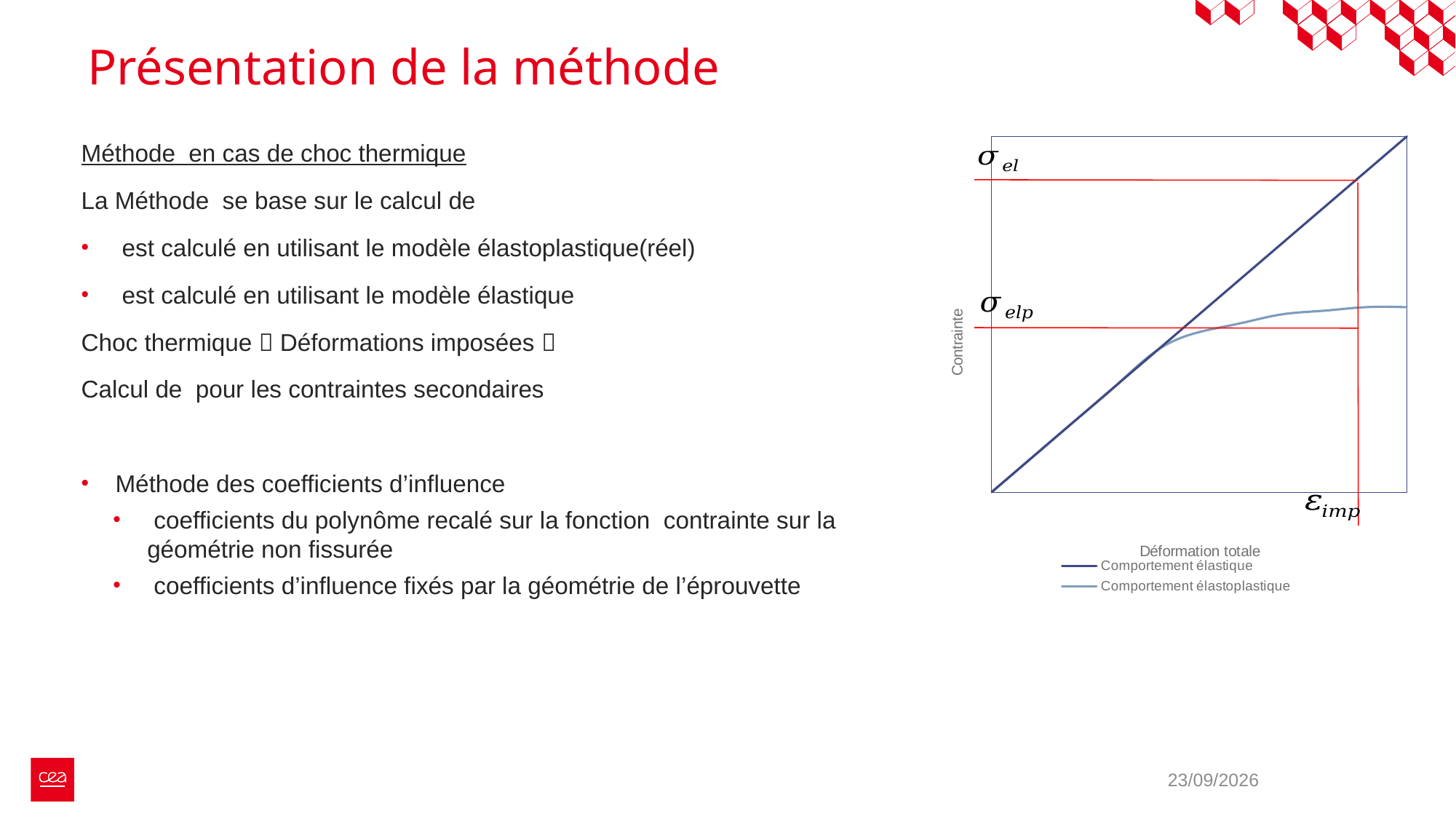
Which series has the lower value at the right end of the chart? Comportement élastoplastique Which stress level marked on the chart is higher: σ_el or σ_elp? σ_el What is the label of the vertical axis of the chart? Contrainte Which series has the higher value at the right end of the chart? Comportement élastique At the strain ε_imp, which series reaches the higher stress: 'Comportement élastique' or 'Comportement élastoplastique'? Comportement élastique Does the 'Comportement élastique' series rise or fall as the x axis increases? rise What are the two series named in the chart legend? Comportement élastique and Comportement élastoplastique How many series does the legend of the chart list? 2 What kind of chart is shown on the slide? line chart Does the 'Comportement élastoplastique' series rise or fall as the x axis increases? rise